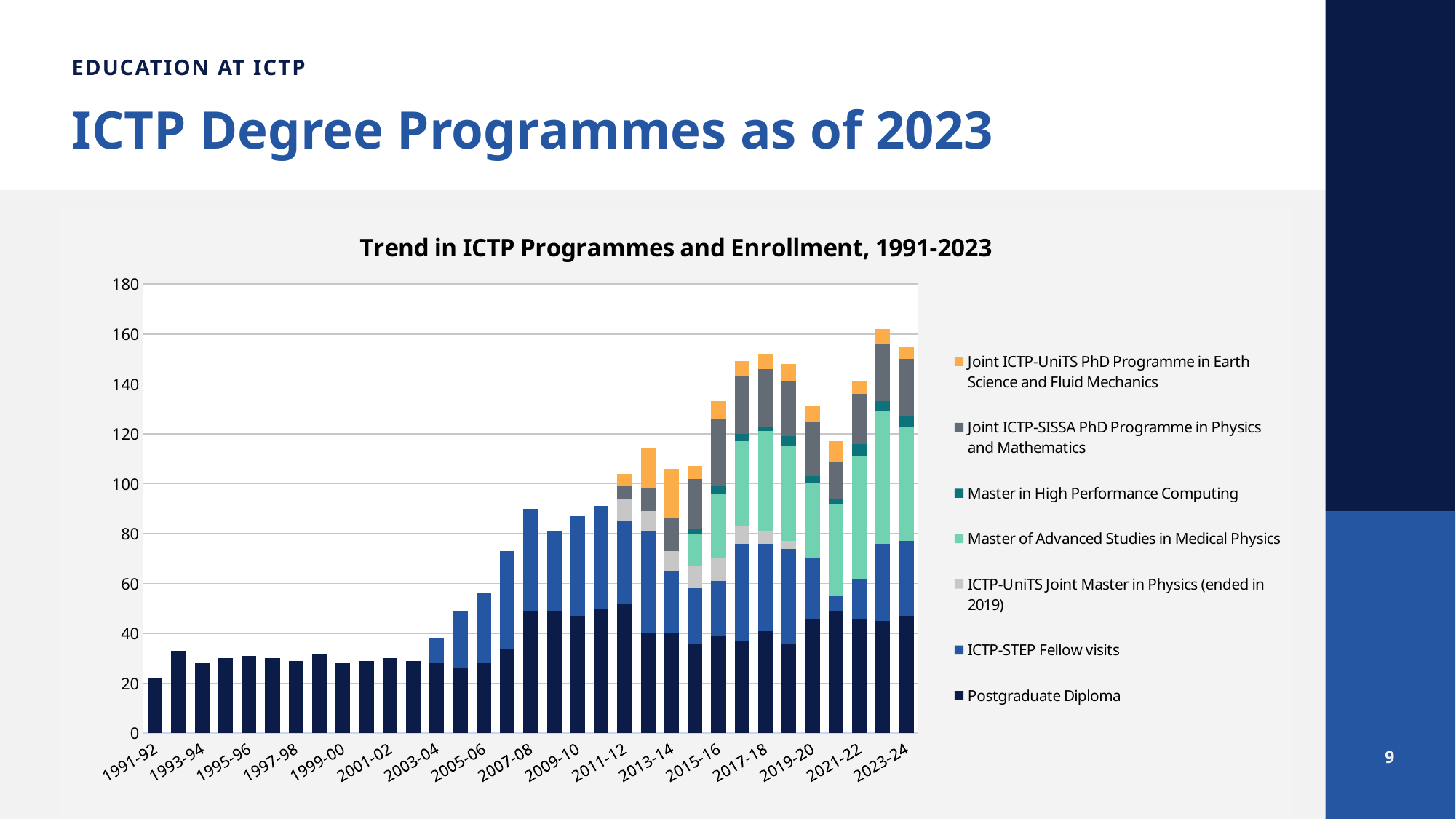
Which series is shown in dark navy at the bottom of each stacked bar? Postgraduate Diploma Is the total for 2007-08 greater or less than 80? greater Is the total for 1991-92 greater or less than 40? less Do the total bar heights generally rise or fall from 1991-92 to 2023-24? rise Is the total for 2023-24 greater or less than 140? greater Which year has the larger total bar, 2003-04 or 2007-08? 2007-08 Which year has the lowest total bar? 1991-92 What is the title of the chart? Trend in ICTP Programmes and Enrollment, 1991-2023 How many series does the legend list? 7 What kind of chart is shown on the slide? Stacked bar chart